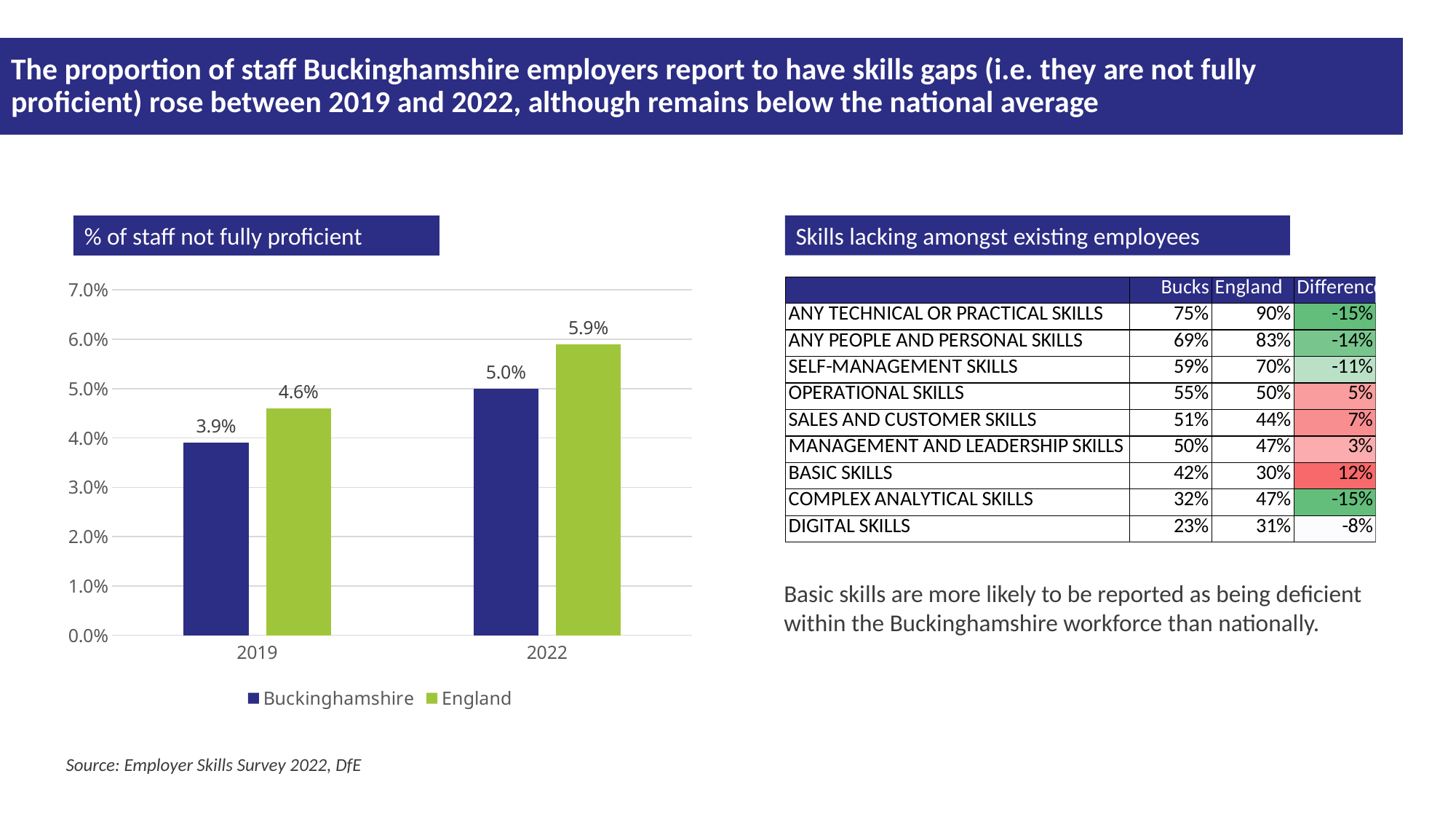
In the '% of staff not fully proficient' chart, what is the difference between England and Buckinghamshire in 2022? 0.9% In the '% of staff not fully proficient' chart, what is the value for England in 2019? 4.6% In the '% of staff not fully proficient' chart, which bar is the lowest overall? Buckinghamshire in 2019 In the '% of staff not fully proficient' chart, what is the value for Buckinghamshire in 2019? 3.9% In the '% of staff not fully proficient' chart, how many years are shown on the x axis? 2 What kind of chart is the '% of staff not fully proficient' chart? Bar chart In the '% of staff not fully proficient' chart, how many series does the legend list? 2 In the '% of staff not fully proficient' chart, which is larger: Buckinghamshire in 2022 or England in 2019? Buckinghamshire in 2022 In the '% of staff not fully proficient' chart, do the Buckinghamshire values rise or fall from 2019 to 2022? Rise In the '% of staff not fully proficient' chart, what is the value for Buckinghamshire in 2022? 5.0% In the '% of staff not fully proficient' chart, what is the value for England in 2022? 5.9% In the '% of staff not fully proficient' chart, which series has the highest value in 2022? England